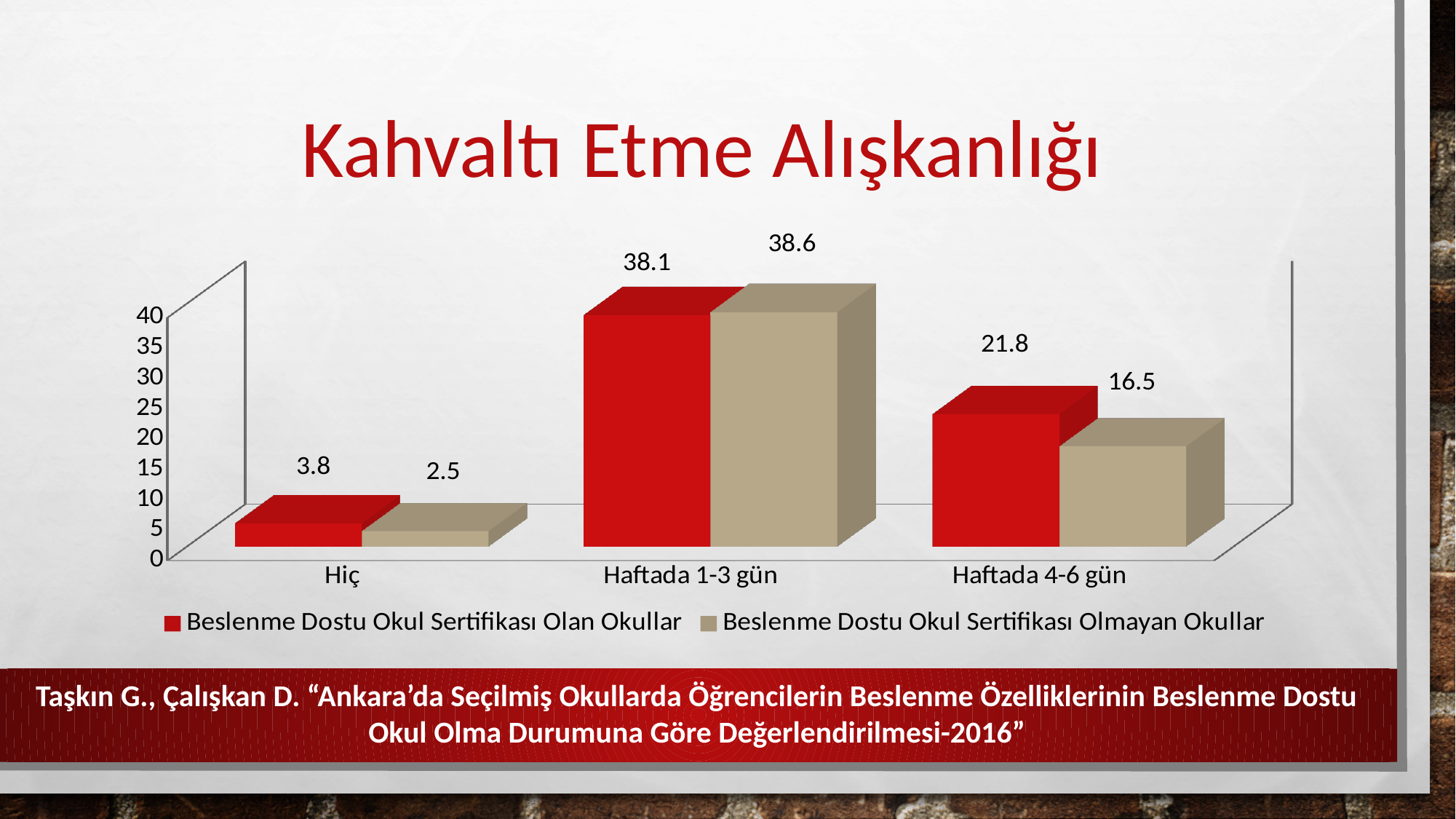
What is the value for 'Beslenme Dostu Okul Sertifikası Olmayan Okullar' in the 'Haftada 4-6 gün' category? 16.5 What is the difference between the two series in the 'Haftada 4-6 gün' category? 5.3 Which category has the lowest value for 'Beslenme Dostu Okul Sertifikası Olmayan Okullar'? Hiç Is the value for 'Beslenme Dostu Okul Sertifikası Olan Okullar' in 'Haftada 4-6 gün' greater or less than 20? greater What is the title of the chart? Kahvaltı Etme Alışkanlığı How many series does the legend list? 2 What kind of chart is shown on the slide? Bar chart In the 'Hiç' category, which series has the larger value? Beslenme Dostu Okul Sertifikası Olan Okullar How many categories are shown on the x axis? 3 What is the value for 'Beslenme Dostu Okul Sertifikası Olan Okullar' in the 'Hiç' category? 3.8 What is the value for 'Beslenme Dostu Okul Sertifikası Olmayan Okullar' in the 'Haftada 1-3 gün' category? 38.6 Which category has the highest value for 'Beslenme Dostu Okul Sertifikası Olan Okullar'? Haftada 1-3 gün